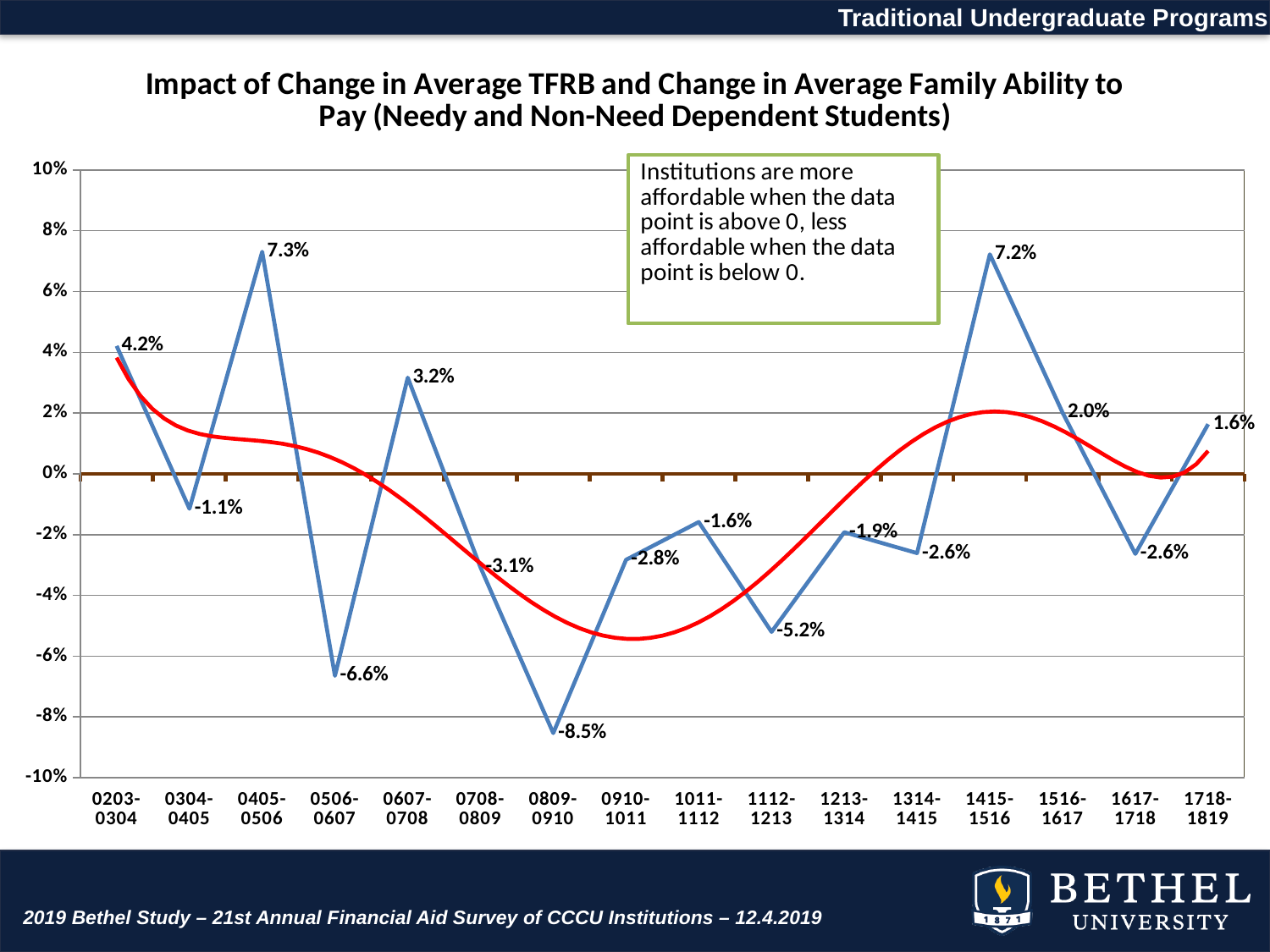
Which period has the lowest value? 0809-0910 What is the value for 0405-0506? 7.3% Which is larger, the value for 0203-0304 or the value for 0607-0708? 0203-0304 What is the difference between the values for 0405-0506 and 1415-1516? 0.1% What kind of chart is shown? line chart What is the value for 0809-0910? -8.5% Is the value for 0506-0607 greater or less than -4%? less How many periods are plotted on the x axis? 16 Do the values rise or fall from 1415-1516 to 1617-1718? fall What is the value for 1718-1819? 1.6% Which period has the highest value? 0405-0506 What is the value for 1112-1213? -5.2%